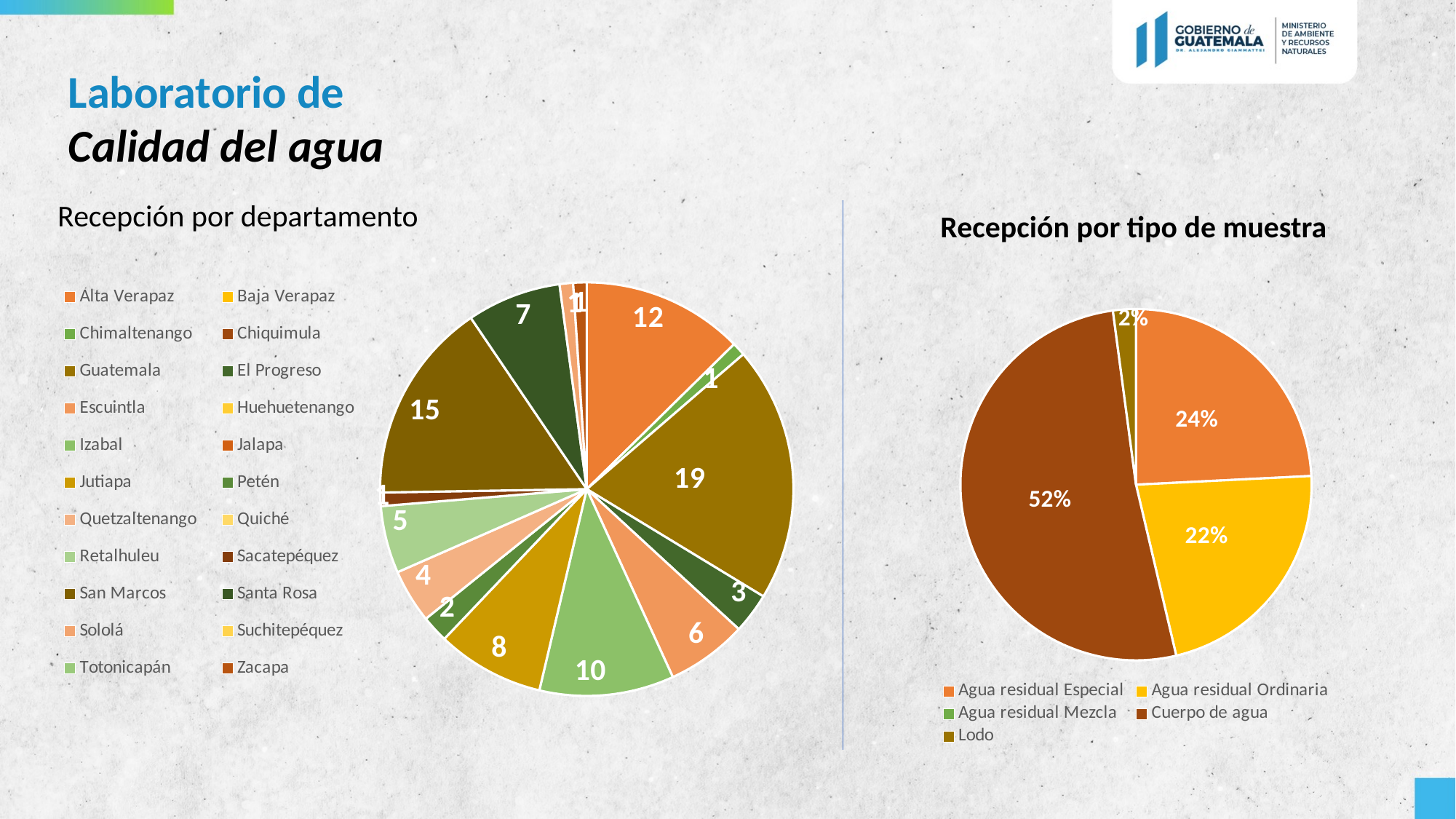
In the 'Recepción por departamento' chart, which department has the largest slice? Guatemala In the 'Recepción por tipo de muestra' chart, what share does Agua residual Ordinaria have? 22% In the 'Recepción por departamento' chart, what is the value for Alta Verapaz? 12 In the 'Recepción por departamento' chart, what is the difference between the values for Guatemala and San Marcos? 4 In the 'Recepción por tipo de muestra' chart, what share does Cuerpo de agua have? 52% In the 'Recepción por departamento' chart, which is larger, the value for Izabal or the value for Jutiapa? Izabal How many entries does the legend of the 'Recepción por tipo de muestra' chart list? 5 In the 'Recepción por departamento' chart, what is the value for San Marcos? 15 In the 'Recepción por departamento' chart, what is the value for Guatemala? 19 In the 'Recepción por departamento' chart, how many departments are listed in the legend? 22 What kind of chart is 'Recepción por tipo de muestra'? Pie chart In the 'Recepción por tipo de muestra' chart, which sample type has the smallest labelled slice? Lodo